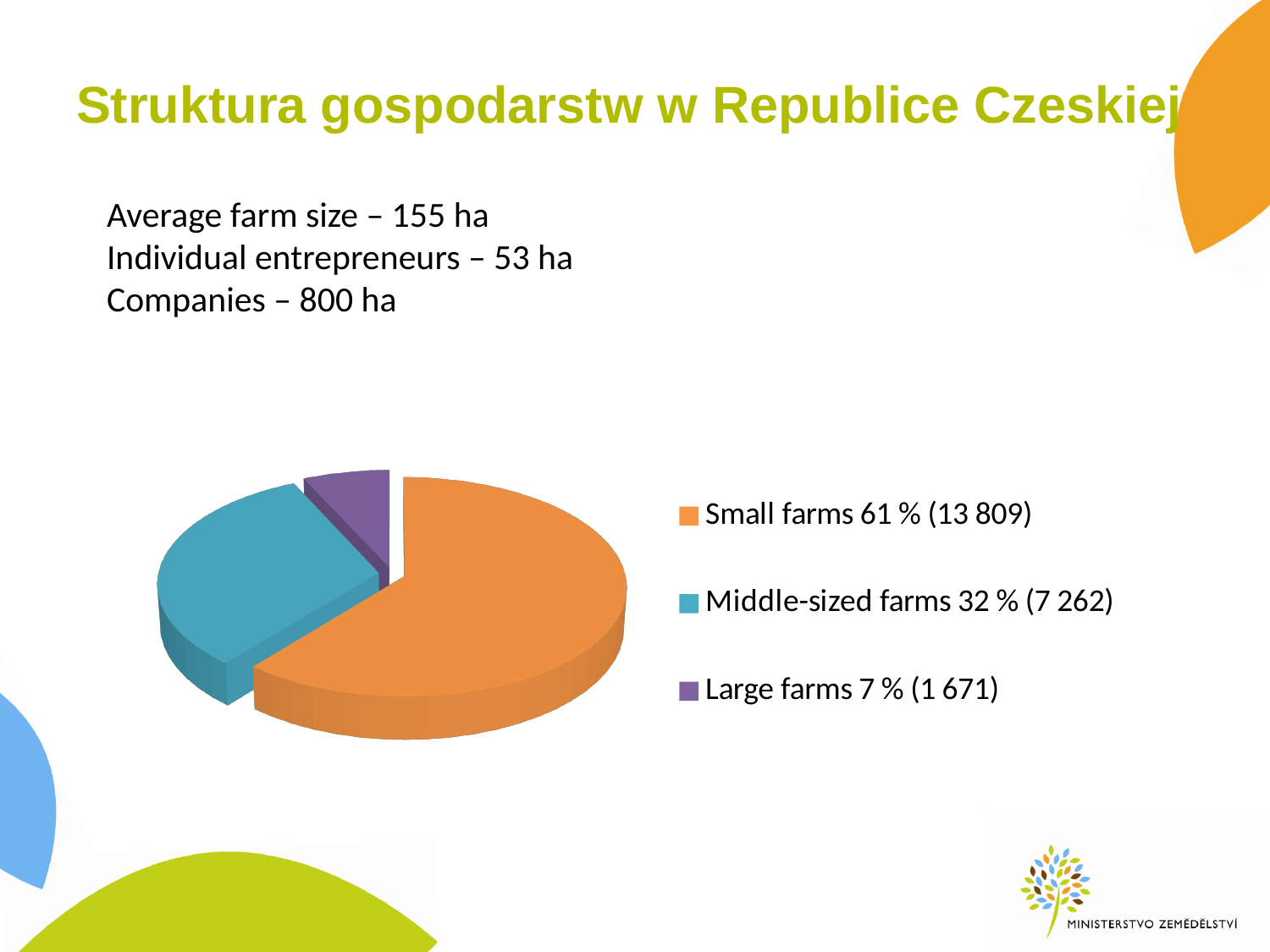
What is the difference in percentage points between the small farms share and the middle-sized farms share? 29 What share of the pie do small farms represent? 61 % Which category has the largest slice of the pie? Small farms What kind of chart is shown on the slide? pie chart How many middle-sized farms are shown in the legend? 7 262 How many small farms are shown in the legend? 13 809 What share of the pie do middle-sized farms represent? 32 % How many large farms are shown in the legend? 1 671 Which category has the smallest slice of the pie? Large farms How many slices does the pie chart have? 3 What share of the pie do large farms represent? 7 % What colour is the slice for middle-sized farms? teal/blue